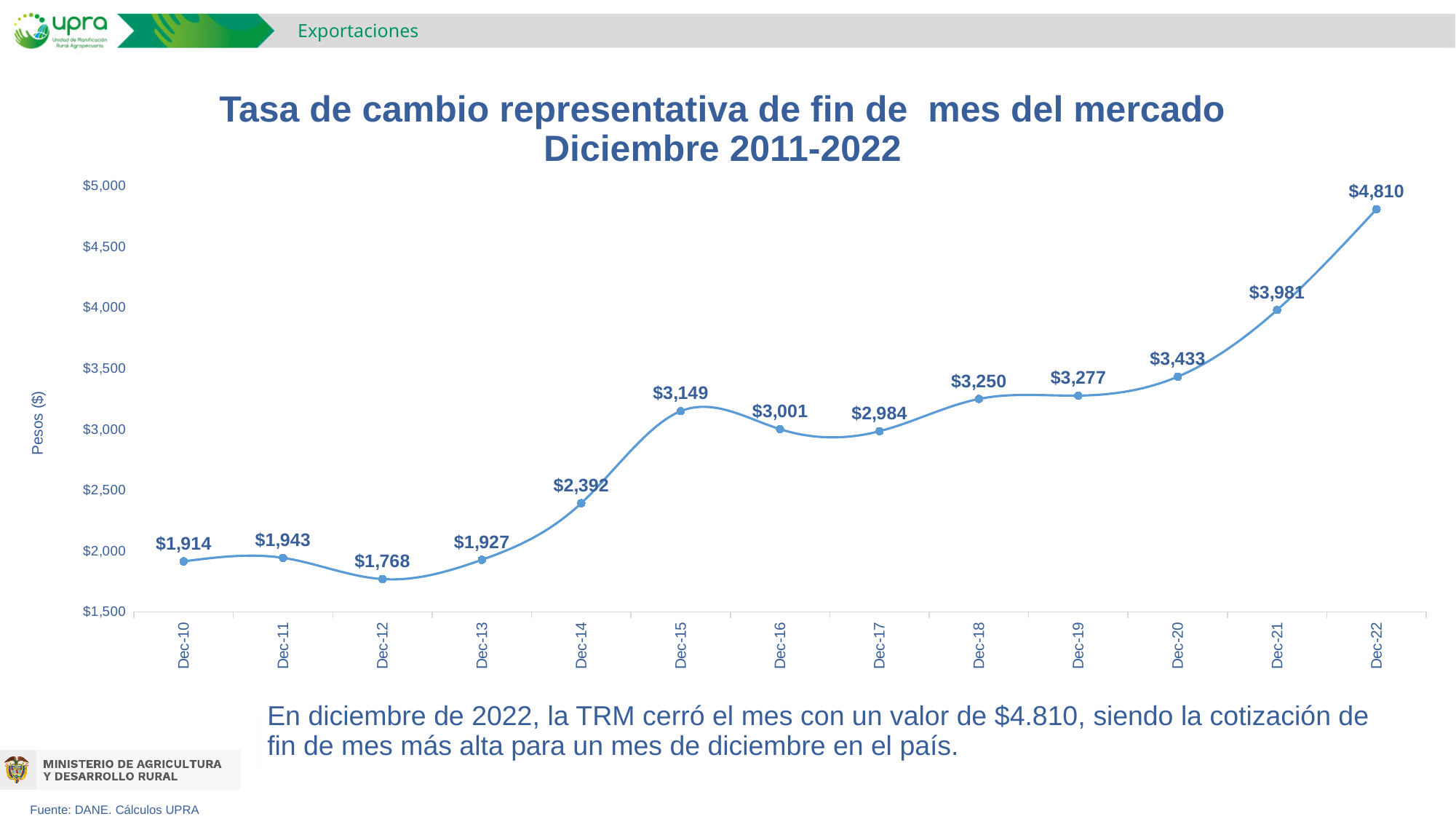
What is the difference between the values for Dec-22 and Dec-21? $829 Is the value for Dec-20 greater or less than $3,500? less Do the values generally rise or fall from Dec-17 to Dec-22? Rise What kind of chart is shown on the slide? Line chart Which point has the lowest value? Dec-12 Which point has the highest value? Dec-22 What is the value for Dec-15? $3,149 What is the value for Dec-22? $4,810 Which is larger, the value for Dec-16 or the value for Dec-17? Dec-16 What is the label of the vertical axis? Pesos ($) What is the value for Dec-12? $1,768 How many data points are plotted on the chart? 13